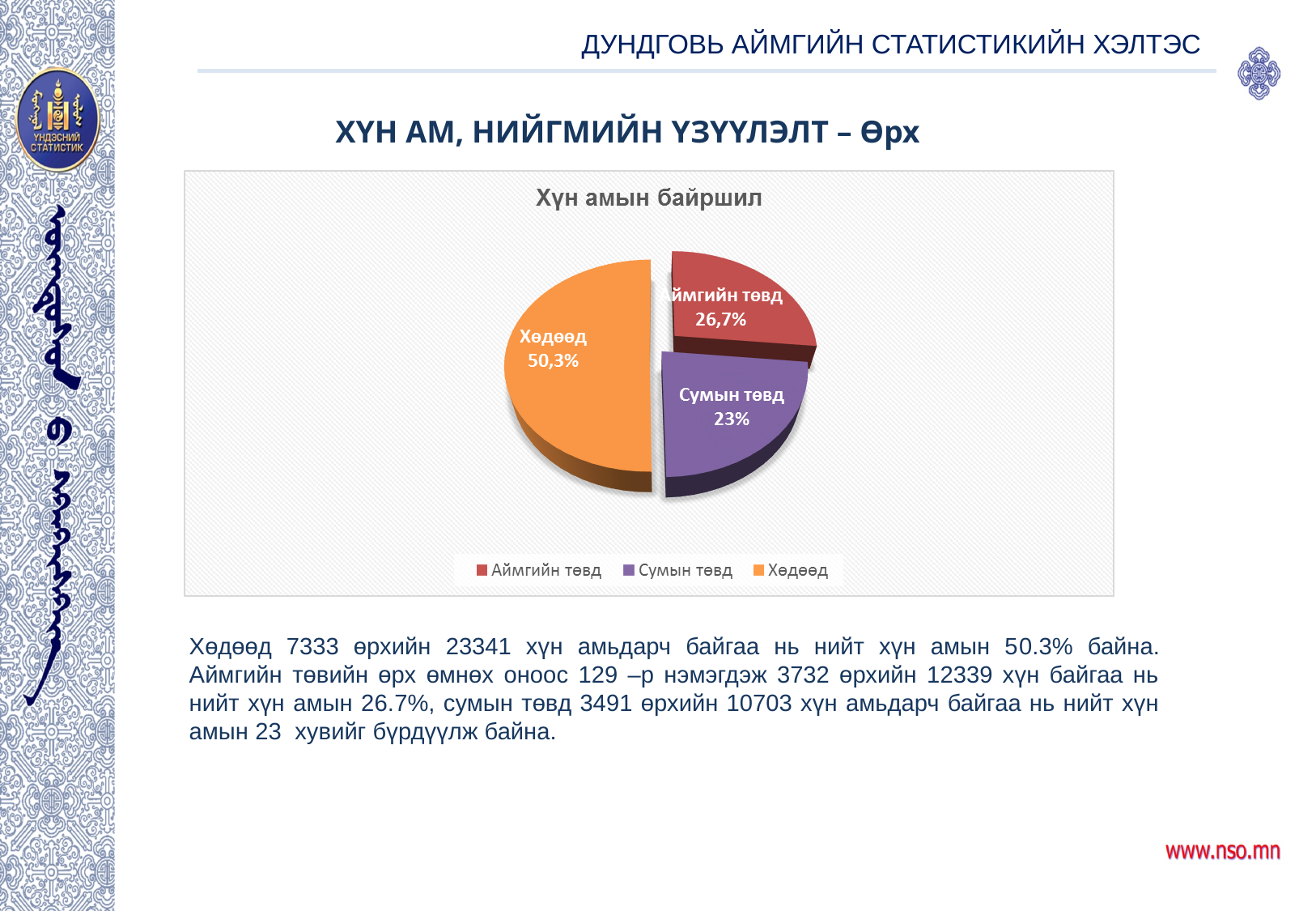
What is the difference between the share for Хөдөөд and the share for Аймгийн төвд? 23,6 percentage points Which slice of the pie is the smallest? Сумын төвд What value is shown for Аймгийн төвд? 26,7% What share of the pie is labelled for Хөдөөд? 50,3% What colour is the Хөдөөд slice in the pie chart? Orange How many entries does the chart legend list? 3 How many slices does the pie chart have? 3 Which is larger, the share for Аймгийн төвд or the share for Сумын төвд? Аймгийн төвд What kind of chart is shown on the slide? Pie chart What value is shown for Сумын төвд? 23% What is the title of the chart? Хүн амын байршил Which slice of the pie is the largest? Хөдөөд